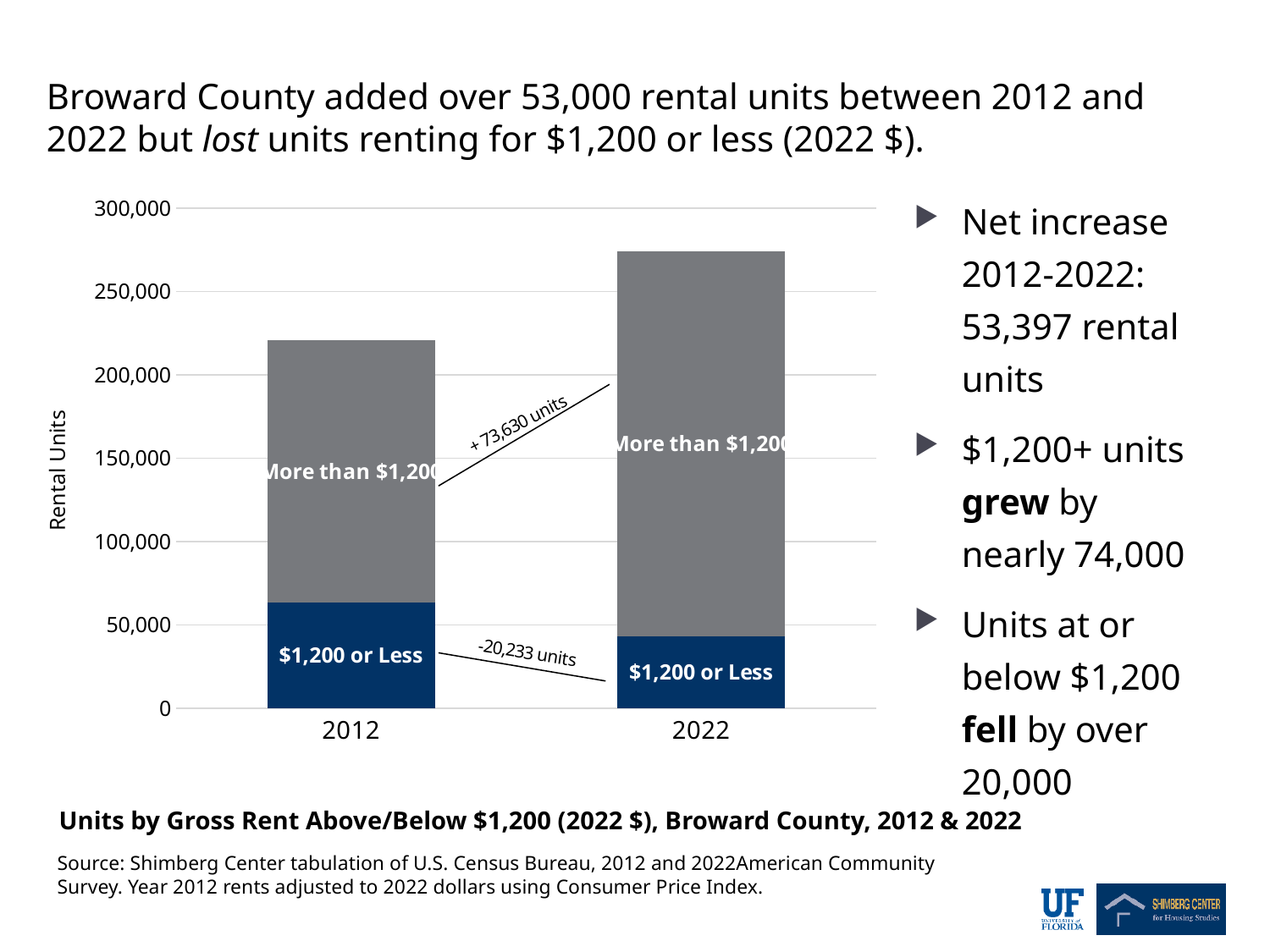
In which year is the '$1,200 or Less' segment larger, 2012 or 2022? 2012 What kind of chart is shown on the slide? Stacked bar chart What is the label on the vertical axis of the chart? Rental Units Is the '$1,200 or Less' segment for 2012 greater or less than 50,000 rental units? greater According to the annotation on the chart, by how many units did the 'More than $1,200' segment change between 2012 and 2022? +73,630 units According to the annotation on the chart, by how many units did the '$1,200 or Less' segment change between 2012 and 2022? -20,233 units Does the total number of rental units rise or fall from 2012 to 2022? Rise Is the total height of the 2012 bar greater or less than 200,000 rental units? greater Which year has the taller total bar, 2012 or 2022? 2022 How many years (categories) are shown on the x axis of the chart? 2 Is the '$1,200 or Less' segment for 2022 greater or less than 50,000 rental units? less